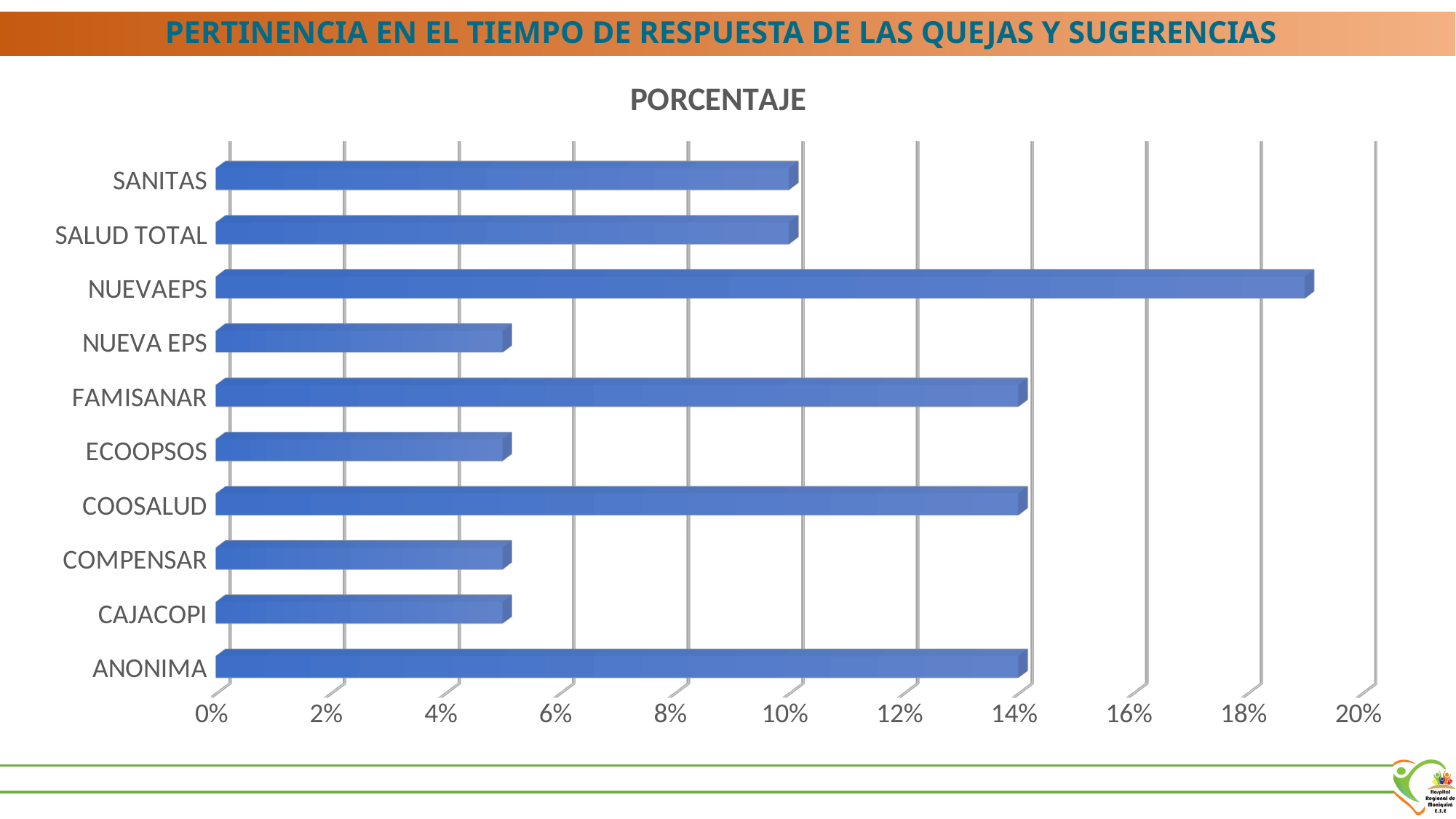
What is the title of the chart? PORCENTAJE Which is larger, the value for SANITAS or the value for ECOOPSOS? SANITAS Which category has the highest value? NUEVAEPS Which is larger, the value for NUEVAEPS or the value for FAMISANAR? NUEVAEPS Is the value for NUEVAEPS greater or less than 18%? greater Is the value for SANITAS greater or less than 12%? less How many categories are plotted in the chart? 10 What kind of chart is shown on the slide? bar chart Which is larger, the value for COOSALUD or the value for COMPENSAR? COOSALUD Is the value for FAMISANAR greater or less than 12%? greater